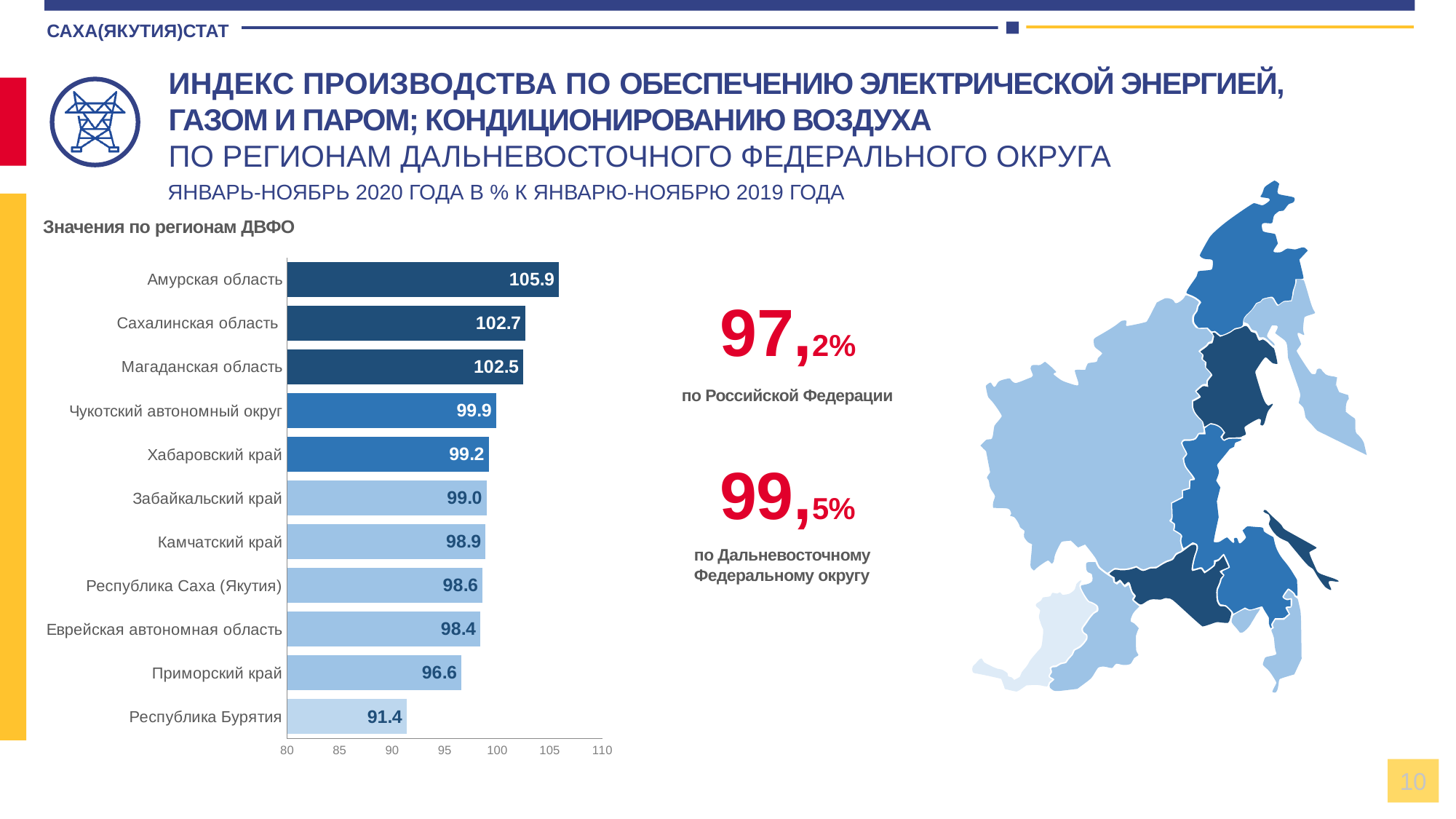
What is the difference between the values for Амурская область and Республика Бурятия? 14.5 What is the value for Республика Саха (Якутия)? 98.6 Which is larger, the value for Хабаровский край or the value for Приморский край? Хабаровский край What kind of chart is shown on the slide? bar chart What is the value for Приморский край? 96.6 Which region has the highest value? Амурская область Which region has the lowest value? Республика Бурятия How many regions are shown in the bar chart? 11 What is the value for Чукотский автономный округ? 99.9 What is the value for Амурская область? 105.9 Is the value for Республика Бурятия greater or less than 95? less What is the difference between the values for Сахалинская область and Магаданская область? 0.2